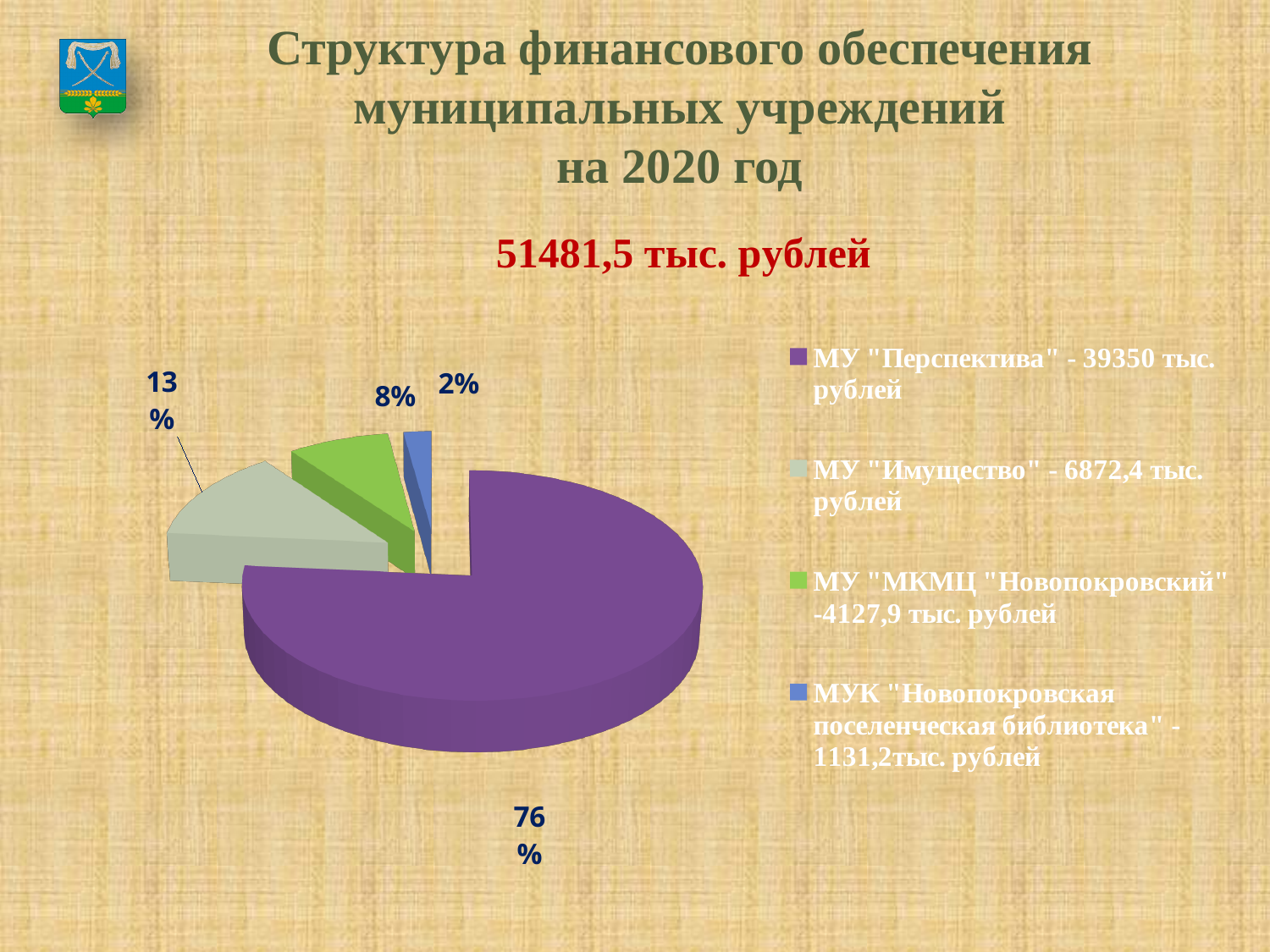
Which category has the largest slice of the pie? МУ "Перспектива" How many entries does the legend list? 4 According to the legend, what amount in тыс. рублей is given for МУ "Имущество"? 6872,4 тыс. рублей What share of the pie does МУК "Новопокровская поселенческая библиотека" take? 2% What share of the pie does МУ "МКМЦ "Новопокровский" take? 8% Which category has the smallest slice of the pie? МУК "Новопокровская поселенческая библиотека" What total amount is shown above the pie chart? 51481,5 тыс. рублей What is the difference in percentage points between the shares of МУ "Имущество" and МУ "МКМЦ "Новопокровский"? 5 percentage points What share of the pie does МУ "Имущество" take? 13% How many slices does the pie chart have? 4 What kind of chart is shown on the slide? Pie chart